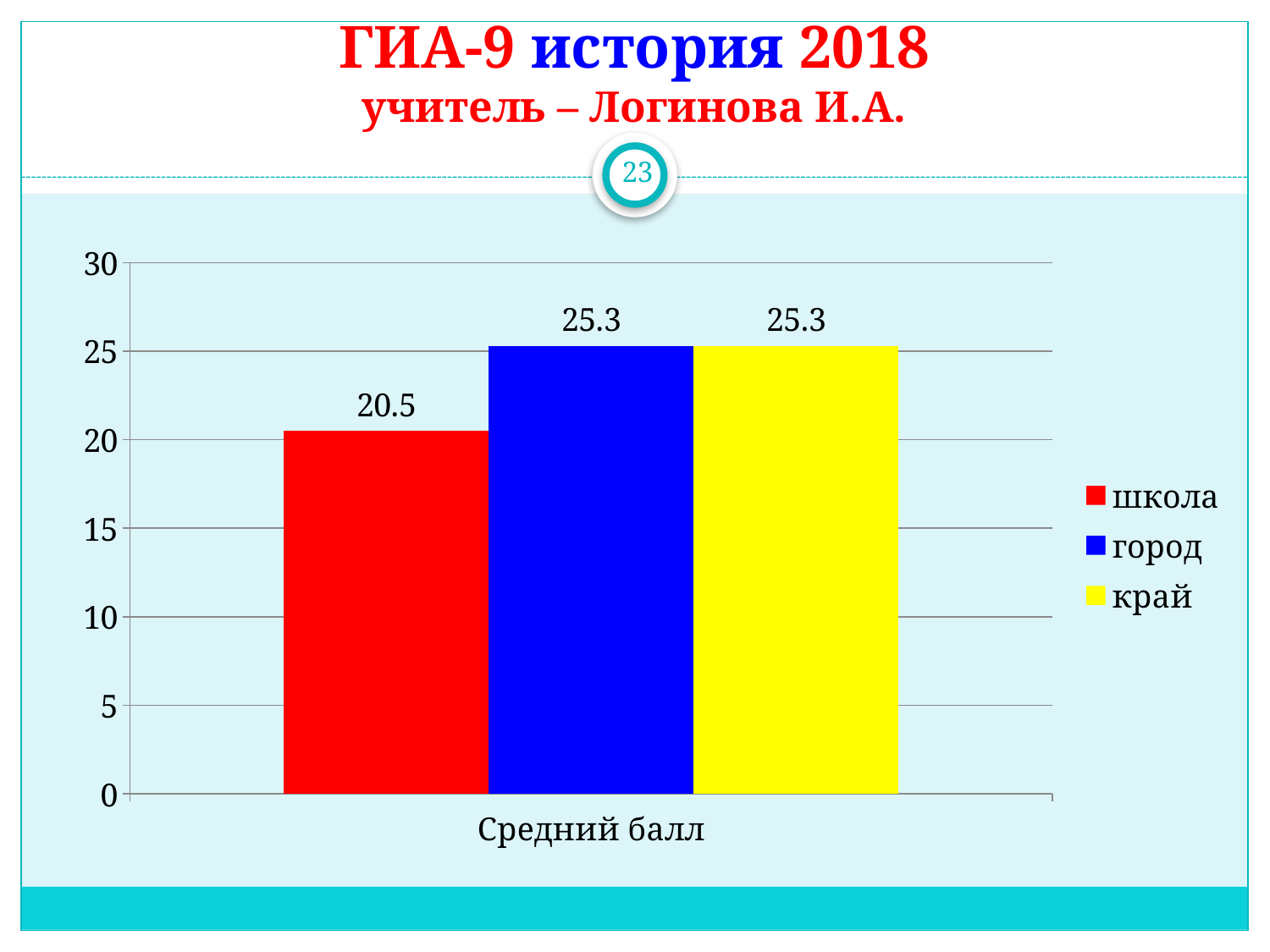
What is the difference between the values for город and школа? 4.8 What is the value for край in the Средний балл chart? 25.3 Is the value for город greater or less than 25? greater How many series does the legend list? 3 What colour is the bar for город? blue Which series has the lowest value in the chart? школа What is the label on the x axis of the chart? Средний балл What is the value for школа in the Средний балл chart? 20.5 Is the value for школа greater or less than 25? less What is the value for город in the Средний балл chart? 25.3 Which is larger, the value for школа or the value for край? край What kind of chart is shown on the slide? bar chart